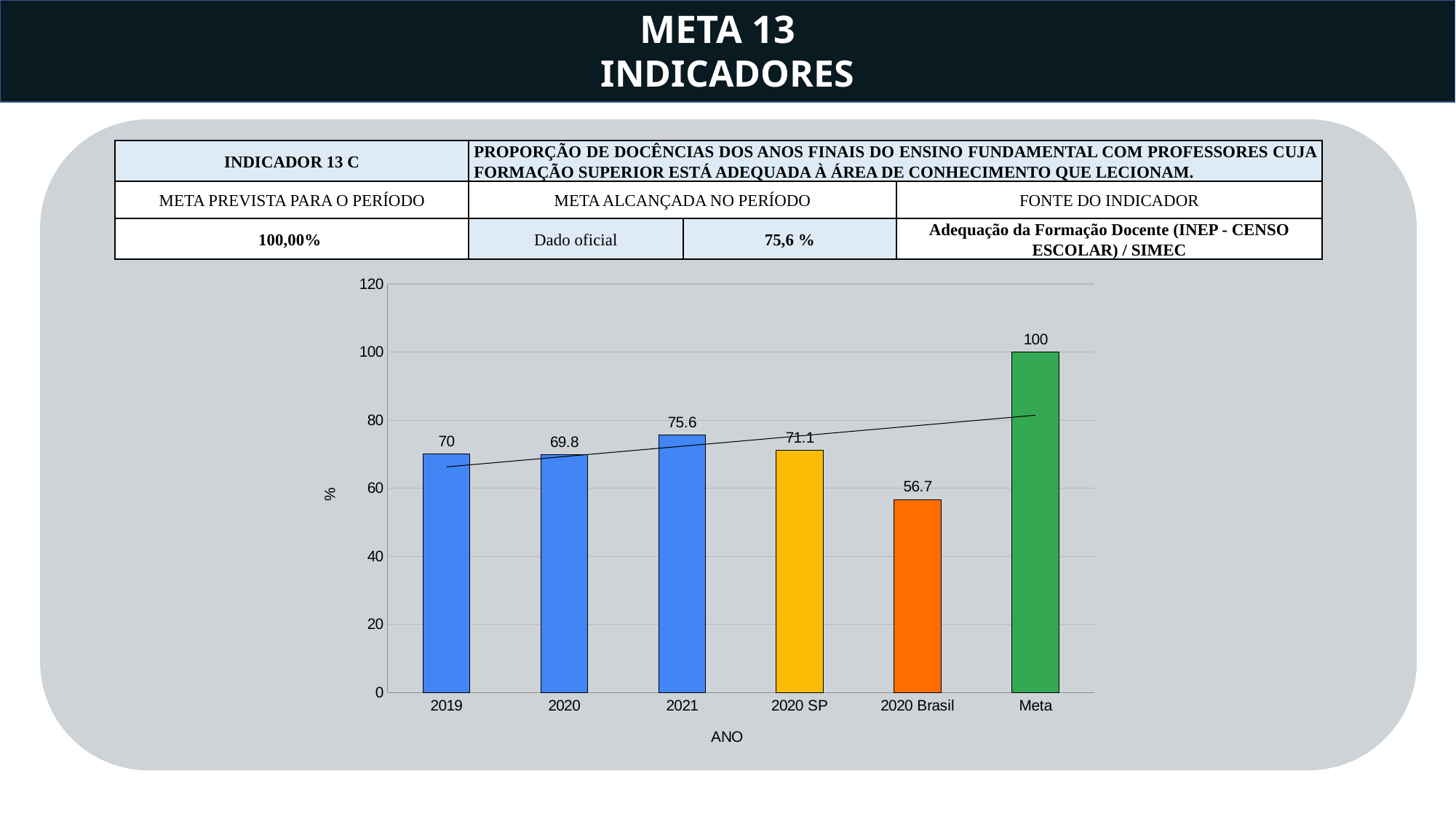
What kind of chart is shown on the slide? bar chart Which category has the lowest value in the chart? 2020 Brasil Which category has the highest value in the chart? Meta What is the value for 2019 in the chart? 70 What is the value for 2021 in the chart? 75.6 What is the difference between the 2020 SP value and the 2020 Brasil value? 14.4 Which is larger, the value for 2021 or the value for 2020 SP? 2021 What is the difference between the Meta value and the 2021 value? 24.4 What is the label of the x axis of the chart? ANO How many bars are plotted in the chart? 6 What is the value for 2020 Brasil in the chart? 56.7 What is the value for 2020 SP in the chart? 71.1